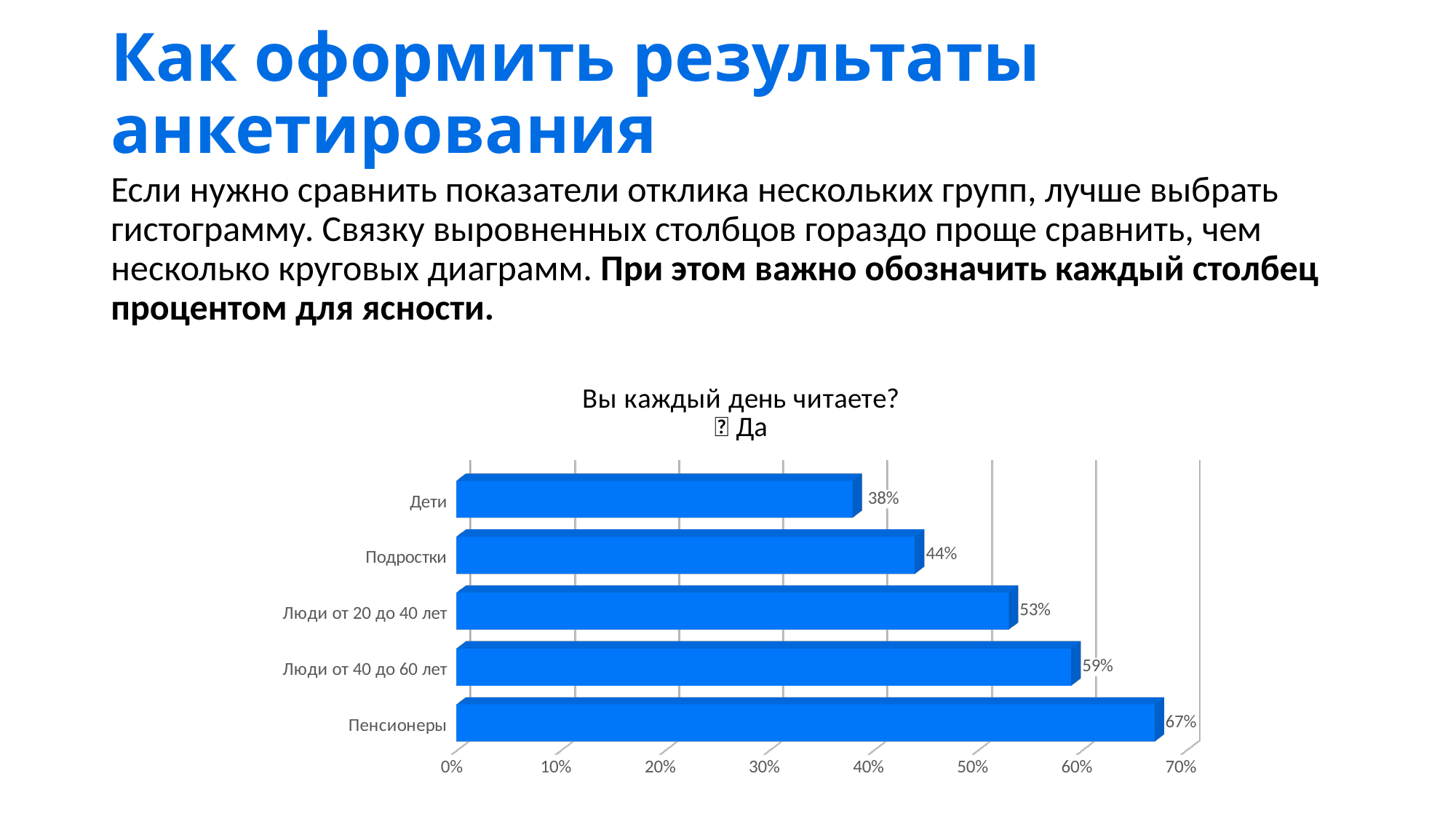
Is the value for Люди от 40 до 60 лет greater or less than 50%? greater What is the title of the chart? Вы каждый день читаете? Да What is the value for Пенсионеры? 67% What is the difference between the values for Пенсионеры and Дети? 29% What is the difference between the values for Люди от 40 до 60 лет and Подростки? 15% What kind of chart is shown on the slide? bar chart What is the value for Дети? 38% Which category has the highest value? Пенсионеры What is the value for Люди от 20 до 40 лет? 53% How many categories are shown in the chart? 5 Which category has the lowest value? Дети Which is larger, the value for Подростки or the value for Люди от 20 до 40 лет? Люди от 20 до 40 лет